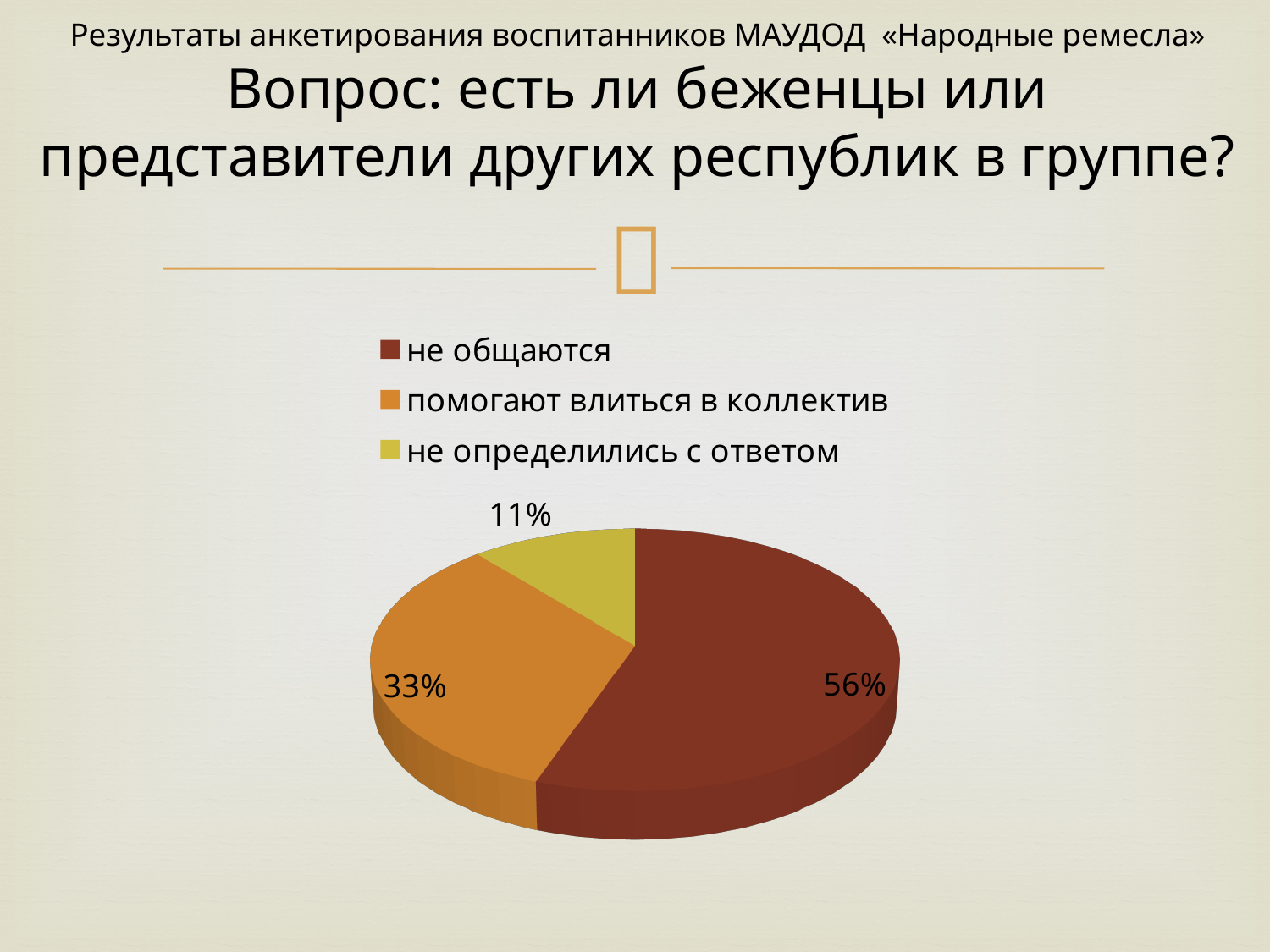
What percentage is shown for "помогают влиться в коллектив"? 33% What percentage is shown for "не определились с ответом"? 11% How many entries does the legend list? 3 Which is larger: the share for "помогают влиться в коллектив" or for "не определились с ответом"? помогают влиться в коллектив What kind of chart is shown on the slide? pie chart What colour is the slice for "не определились с ответом"? yellow What is the difference in percentage points between "не общаются" and "помогают влиться в коллектив"? 23 How many slices does the pie chart have? 3 What is the difference in percentage points between "помогают влиться в коллектив" and "не определились с ответом"? 22 What percentage is shown for "не общаются"? 56% Which category has the smallest share of the pie? не определились с ответом Which category has the largest share of the pie? не общаются